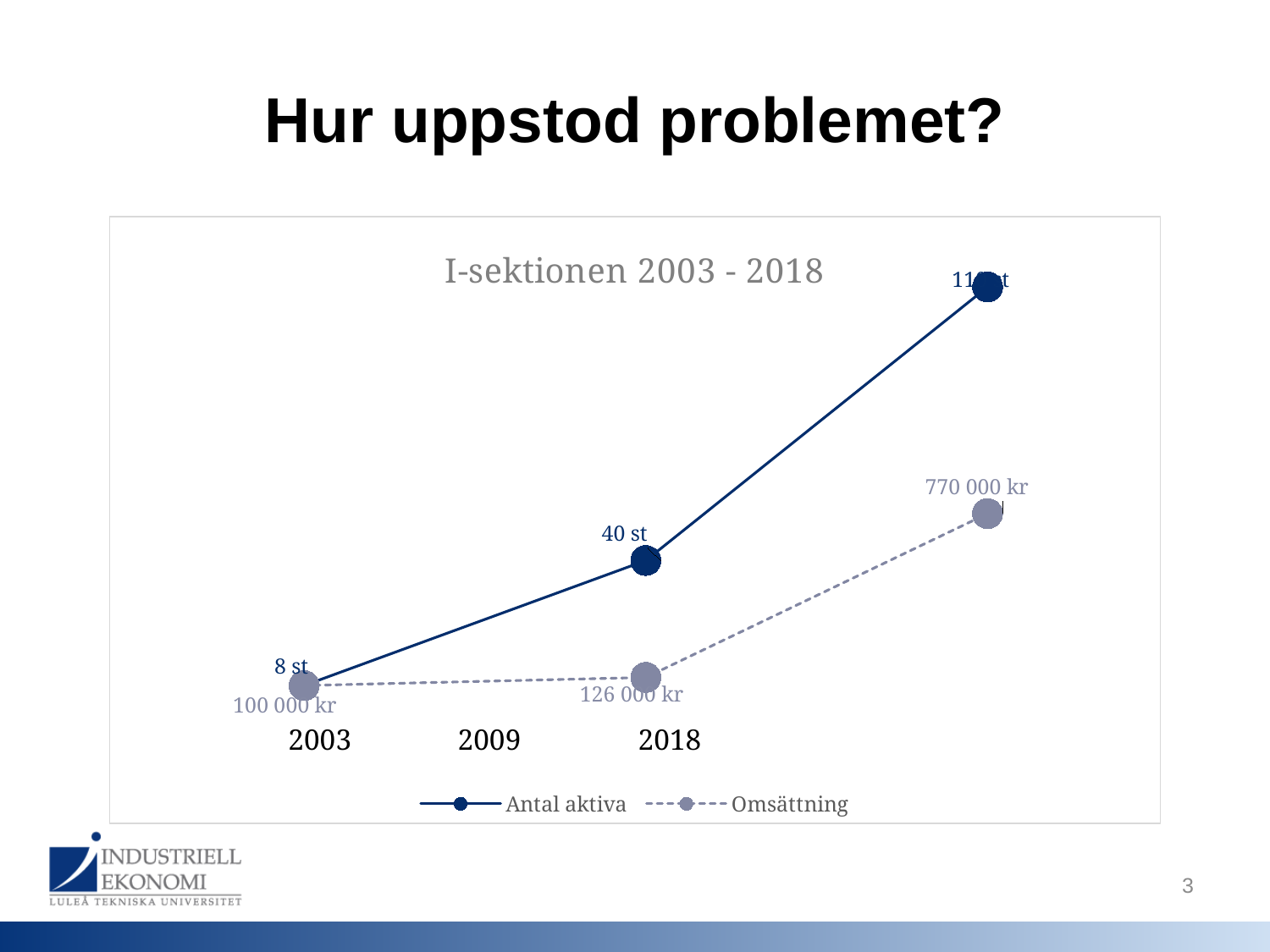
Do the Omsättning values rise or fall from left to right along the x axis? Rise What is the value of Antal aktiva at the first point (2003)? 8 st What is the difference between the highest Omsättning value (770 000 kr) and the middle value (126 000 kr)? 644 000 kr What is the highest Omsättning value shown on the chart? 770 000 kr What is the value of Omsättning at the middle point of the line? 126 000 kr Which two series are listed in the chart legend? Antal aktiva and Omsättning What is the title of the chart? I-sektionen 2003 - 2018 What is the difference between the middle Antal aktiva value (40 st) and the first value (8 st)? 32 st What kind of chart is shown on the slide? Line chart What is the value of Antal aktiva at the middle point of the line? 40 st How many series does the chart legend list? 2 What is the value of Omsättning at the first point (2003)? 100 000 kr